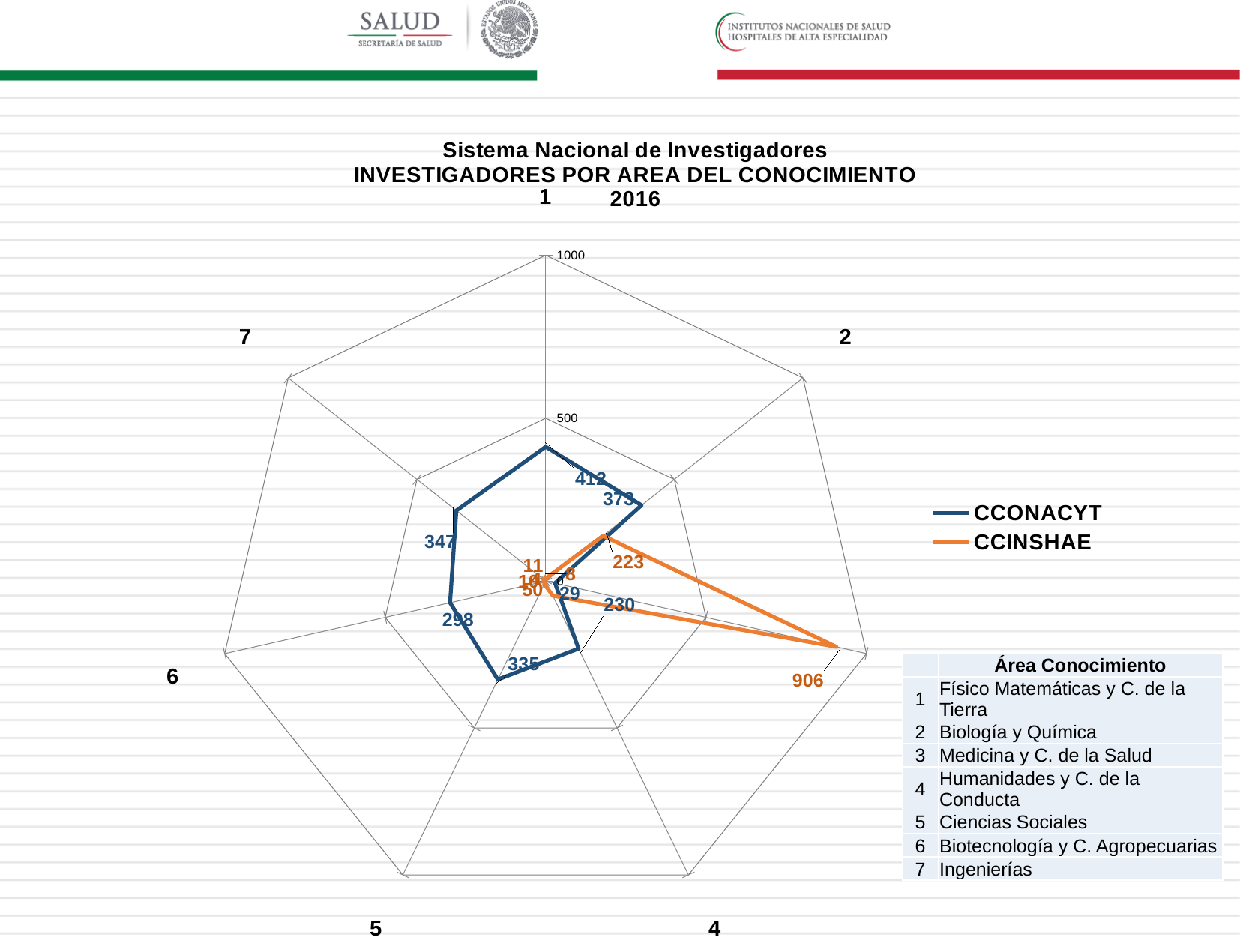
What is the CCONACYT value for area 7 (Ingenierías)? 347 What is the CCINSHAE value for area 3 (Medicina y C. de la Salud)? 906 Which is larger: the CCINSHAE value for area 3 or the CCONACYT value for area 1? CCINSHAE value for area 3 Which area has the highest CCINSHAE value? 3 (Medicina y C. de la Salud) What are the two series named in the legend? CCONACYT and CCINSHAE What is the CCONACYT value for area 1 (Físico Matemáticas y C. de la Tierra)? 412 What kind of chart is shown on the slide? Radar chart What is the difference between the CCINSHAE values for area 3 and area 2? 683 Is the CCINSHAE value for area 3 greater or less than 500? greater How many series does the legend list? 2 How many knowledge areas (categories) are plotted on the radar chart? 7 What is the CCINSHAE value for area 2 (Biología y Química)? 223